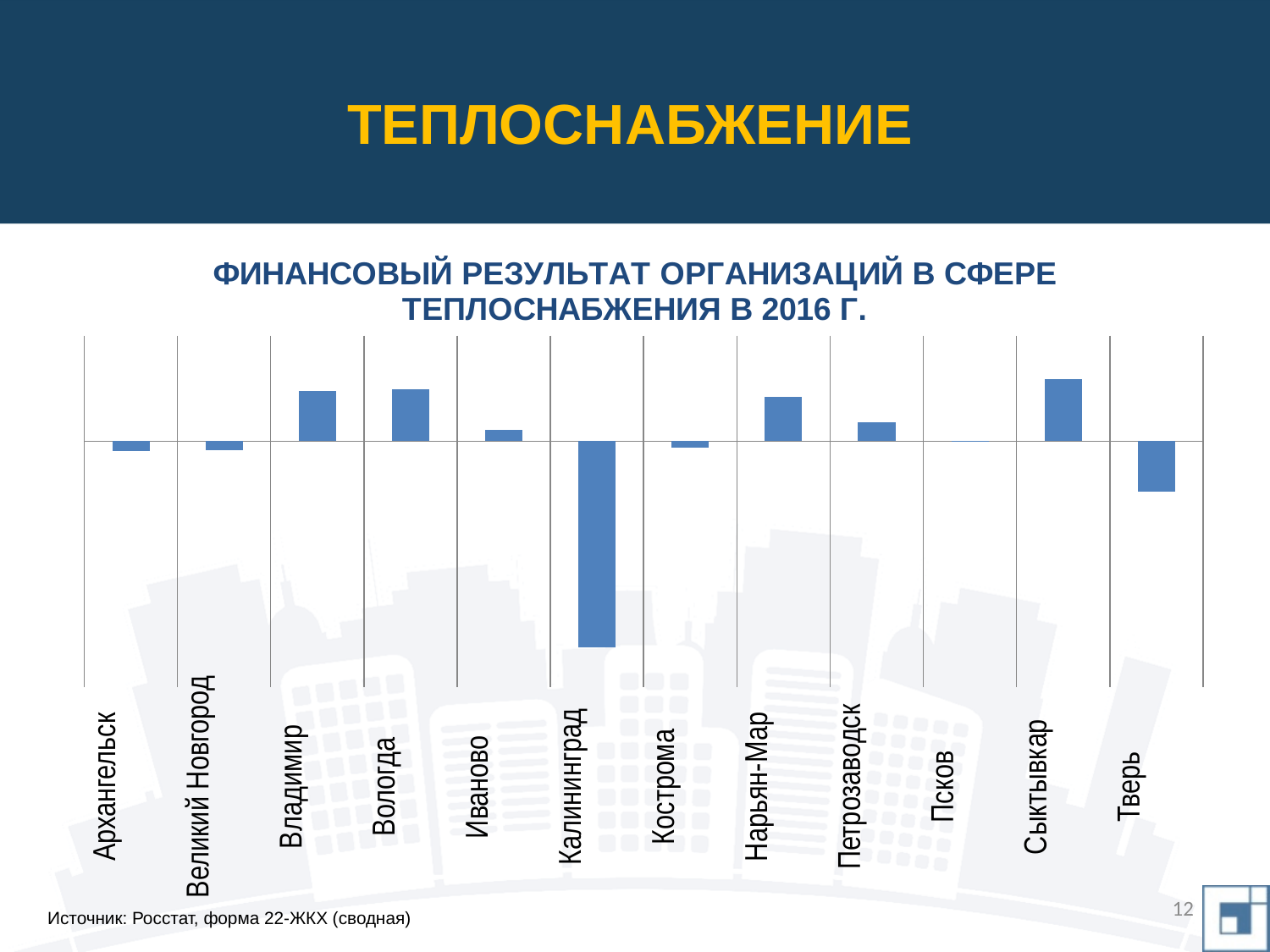
Which has the larger value, Нарьян-Мар or Петрозаводск? Нарьян-Мар Which has the larger value, Иваново or Кострома? Иваново What kind of chart is shown on the slide? Bar chart Which has the larger value, Сыктывкар or Владимир? Сыктывкар Is the value for Тверь greater or less than 0? less Is the value for Вологда greater or less than 0? greater How many cities are shown on the x axis of the chart? 12 Which city has the lowest financial result in the chart? Калининград What is the title of the chart? ФИНАНСОВЫЙ РЕЗУЛЬТАТ ОРГАНИЗАЦИЙ В СФЕРЕ ТЕПЛОСНАБЖЕНИЯ В 2016 Г. How many cities in the chart have a negative financial result? 5 Which city has the highest financial result in the chart? Сыктывкар